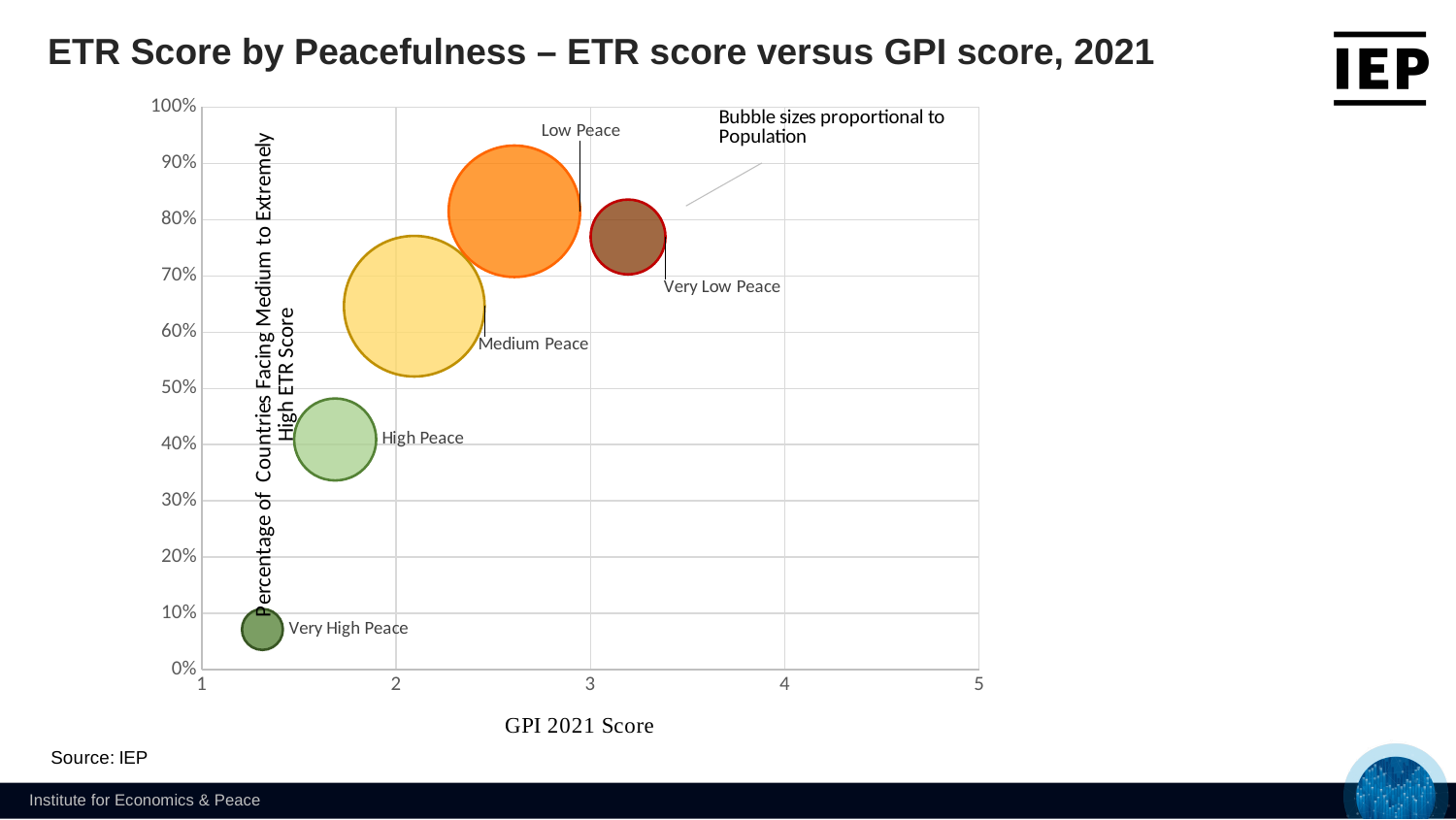
Is the percentage value for Medium Peace greater or less than 60%? greater What kind of chart is shown on the slide? Bubble chart Is the percentage value for High Peace greater or less than 50%? less Which peacefulness category has the highest percentage of countries facing medium to extremely high ETR score? Low Peace Is the percentage value for Very High Peace greater or less than 10%? less How many peacefulness categories (bubbles) are plotted on the chart? 5 As the GPI 2021 Score increases along the x axis, does the percentage of countries facing medium to extremely high ETR score generally rise or fall? Rise Which peacefulness category has the lowest percentage of countries facing medium to extremely high ETR score? Very High Peace According to the note on the chart, what are the bubble sizes proportional to? Population Which has a higher percentage of countries facing medium to extremely high ETR score, High Peace or Medium Peace? Medium Peace